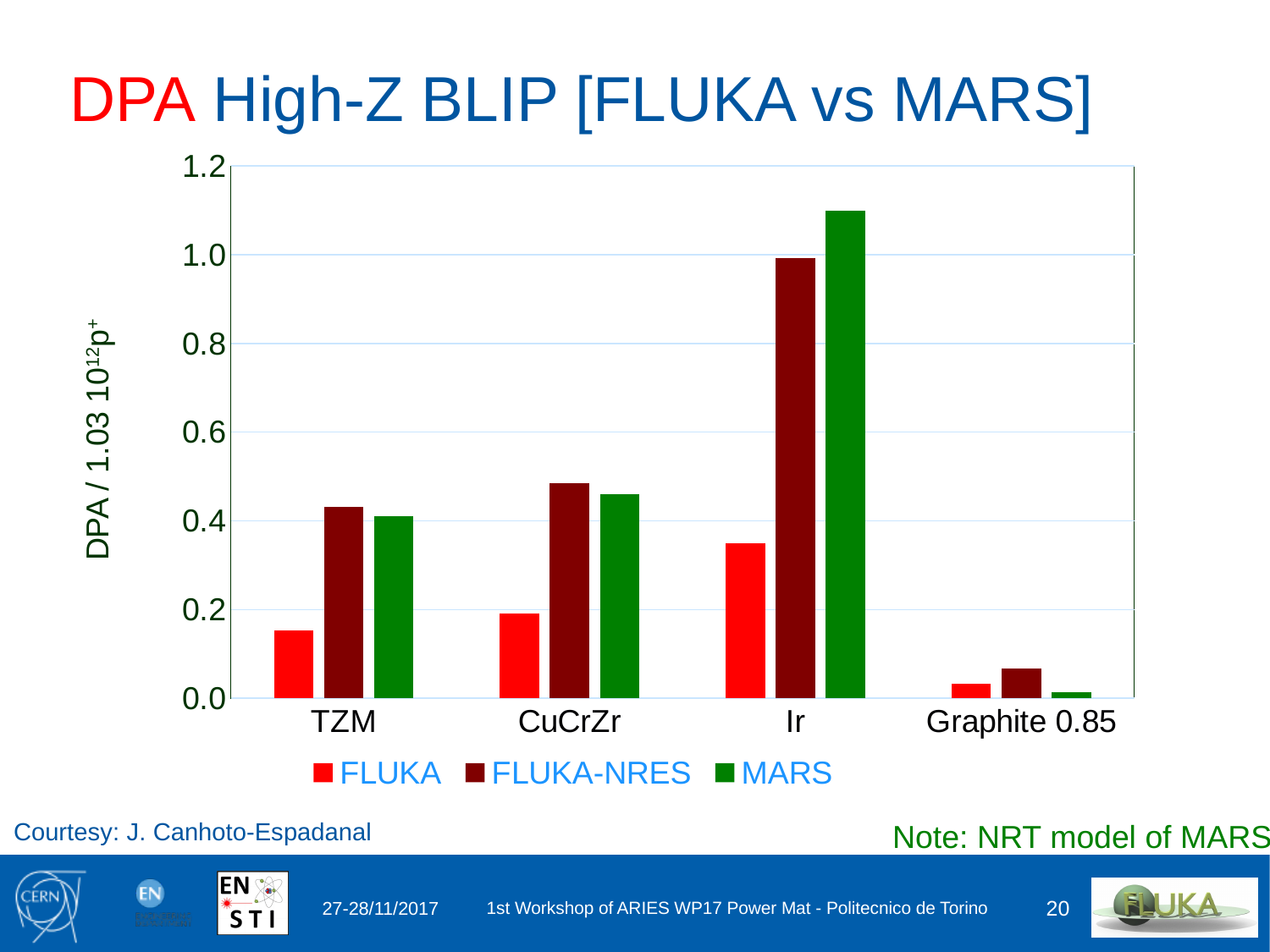
Which material has the highest MARS value? Ir Is the FLUKA value for TZM greater or less than 0.2? less For Graphite 0.85, which is larger: the FLUKA-NRES value or the MARS value? FLUKA-NRES What is the label of the y axis? DPA / 1.03 10^12 p+ How many material categories are shown on the x axis? 4 Which material has the lowest FLUKA value? Graphite 0.85 For Ir, which is larger: the MARS value or the FLUKA value? MARS What type of chart is shown on the slide? bar chart Is the MARS value for Ir greater or less than 1.0? greater Is the FLUKA-NRES value for CuCrZr greater or less than 0.4? greater Which series is shown in green in the legend? MARS How many series does the legend list? 3